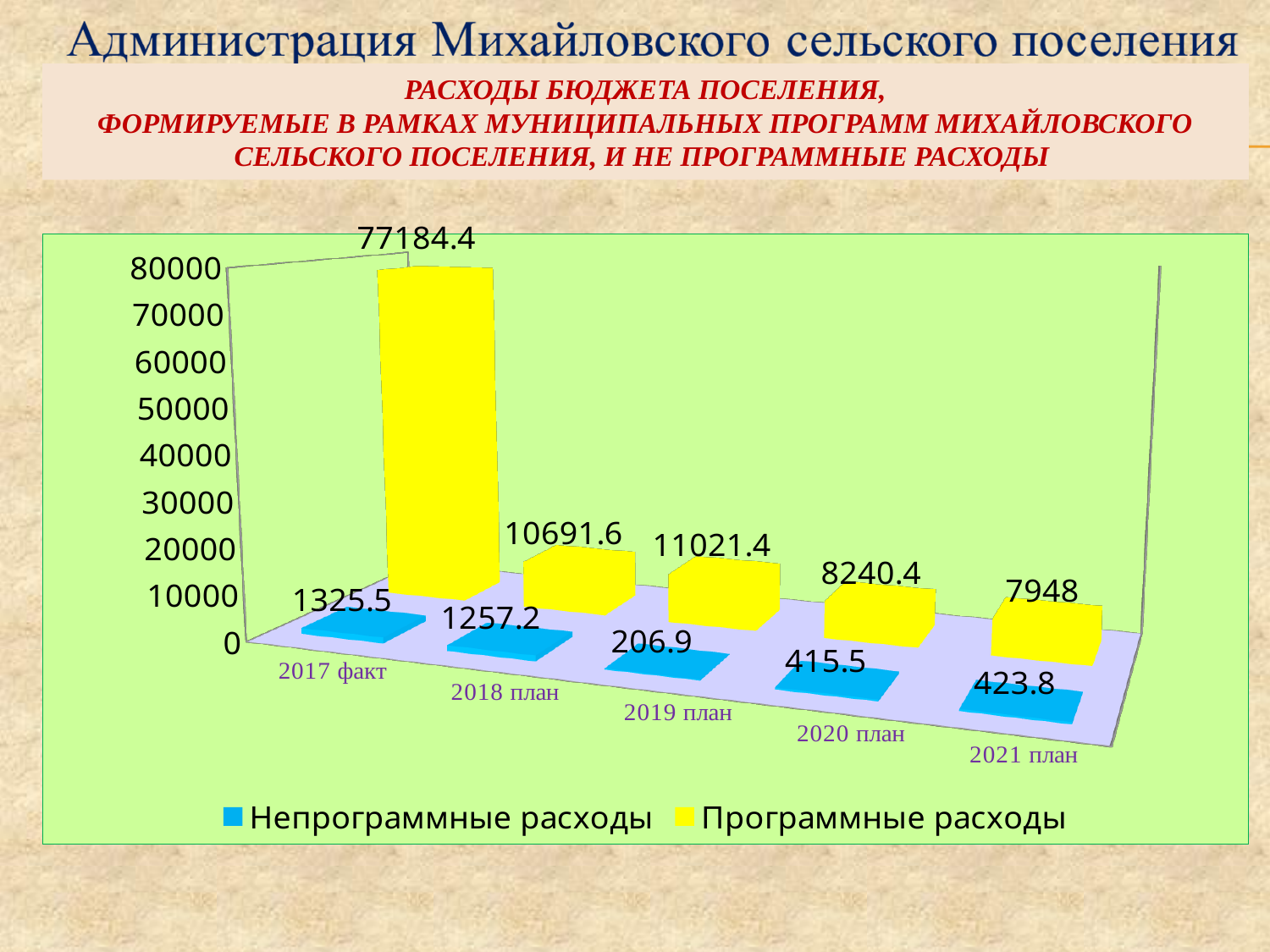
What is the value of Непрограммные расходы for 2019 план? 206.9 What is the value of Непрограммные расходы for 2018 план? 1257.2 What is the difference between Программные расходы for 2019 план and 2018 план? 329.8 What kind of chart is shown on the slide? Bar chart What is the value of Программные расходы for 2021 план? 7948 Which category has the highest value for Программные расходы? 2017 факт Which category has the lowest value for Непрограммные расходы? 2019 план Which is larger: Непрограммные расходы for 2020 план or for 2021 план? 2021 план What is the value of Программные расходы for 2017 факт? 77184.4 How many categories are shown on the x axis? 5 How many series does the legend list? 2 Which colour represents Программные расходы in the chart? Yellow